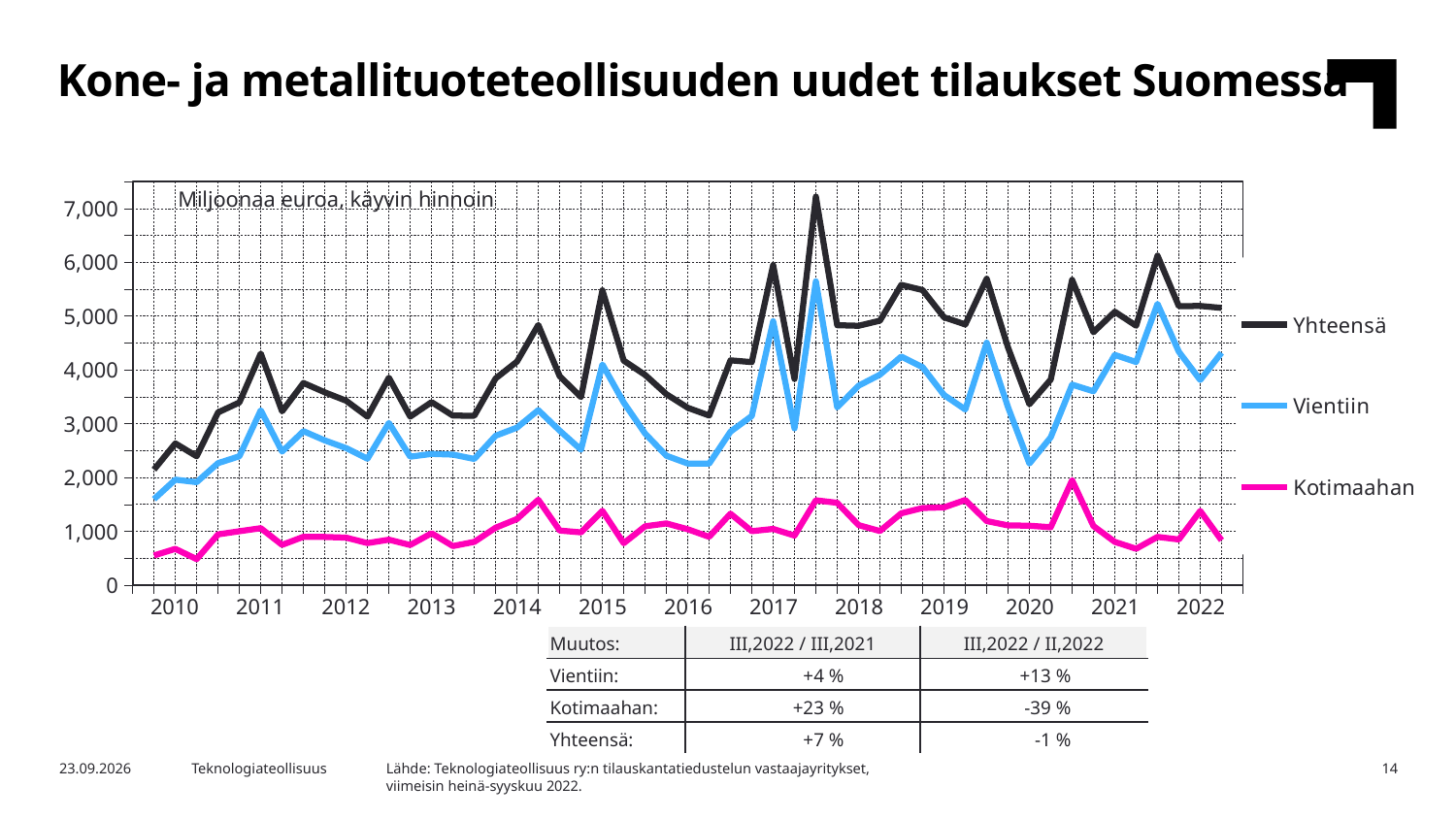
What unit is stated inside the chart area? Miljoonaa euroa, käyvin hinnoin Which series has the highest values throughout the chart? Yhteensä Is the peak value of Yhteensä in 2017 greater or less than 6,000? greater Which series is larger in 2022, Vientiin or Kotimaahan? Vientiin Is the peak value of Vientiin in 2017 greater or less than 5,000? greater Which series has the lowest values throughout the chart? Kotimaahan What kind of chart is shown on the slide? line chart Is the first value of Kotimaahan in 2010 greater or less than 1,000? less How many year labels are shown on the x axis? 13 Which series is shown with the black line in the chart? Yhteensä How many series does the chart legend list? 3